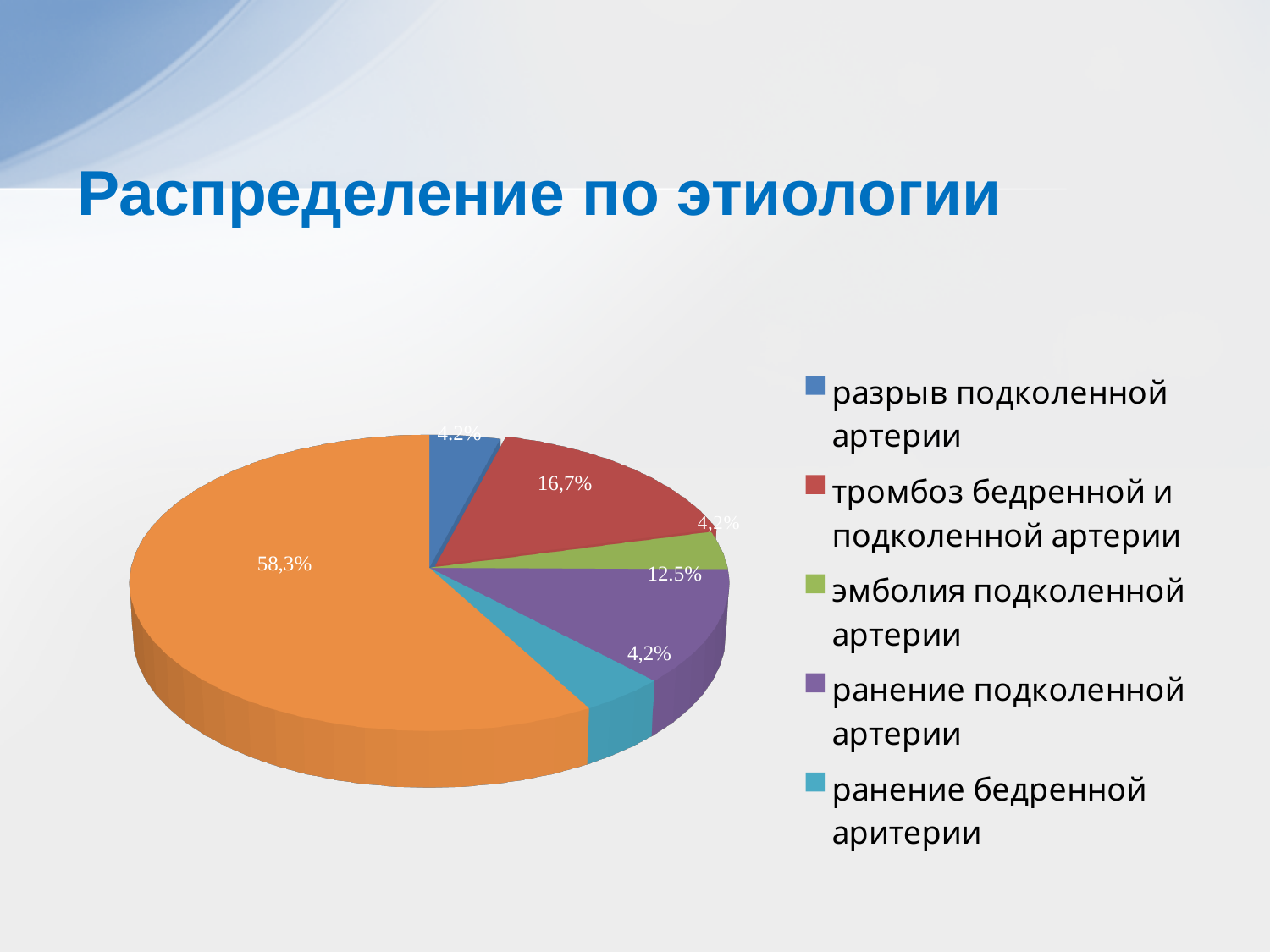
What is the title of the chart? Распределение по этиологии What is the difference between the shares for тромбоз бедренной и подколенной артерии and разрыв подколенной артерии? 12,5% What share of the pie is labelled for эмболия подколенной артерии? 4,2% What share of the pie is labelled for тромбоз бедренной и подколенной артерии? 16,7% How many entries does the legend list? 5 What share of the pie is labelled for ранение подколенной артерии? 12.5% What kind of chart is shown on the slide? pie chart What is the value labelled on the largest slice of the pie? 58,3% Which is larger: the slice for тромбоз бедренной и подколенной артерии or the slice for ранение подколенной артерии? тромбоз бедренной и подколенной артерии What share of the pie is labelled for ранение бедренной аритерии? 4,2% What is the difference between the shares for тромбоз бедренной и подколенной артерии and ранение подколенной артерии? 4,2% What share of the pie is labelled for разрыв подколенной артерии? 4,2%